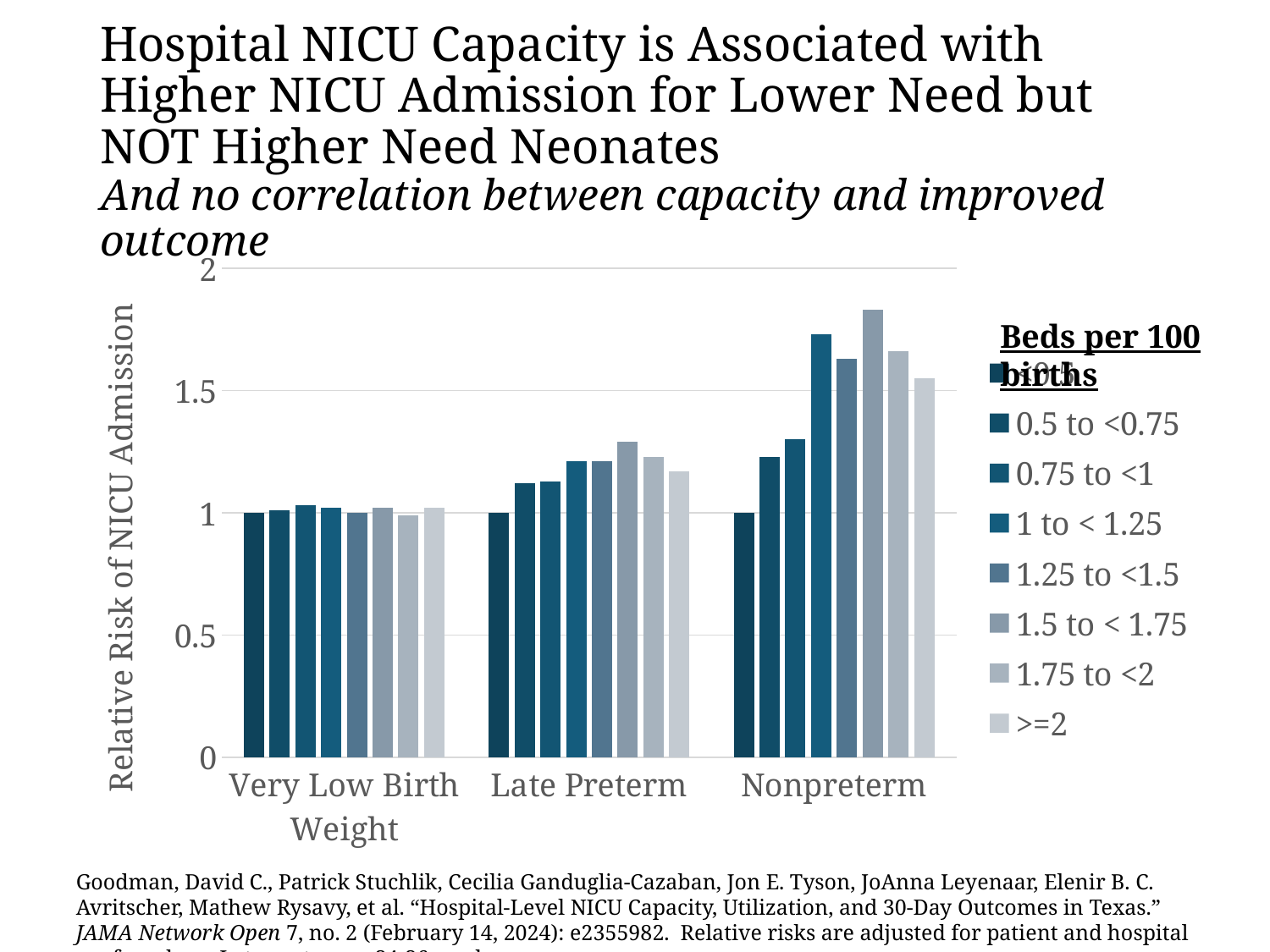
What kind of chart is shown on the slide? bar chart What is the title of the y axis? Relative Risk of NICU Admission For the >=2 series, which is larger: the value for Late Preterm or the value for Very Low Birth Weight? Late Preterm Within the Nonpreterm group, which series has the highest relative risk? 1.5 to < 1.75 How many categories are shown on the x axis of the chart? 3 What is the heading of the legend? Beds per 100 births For the >=2 series, do the values rise or fall moving from Very Low Birth Weight to Nonpreterm along the x axis? rise Is the value for the 1.5 to < 1.75 series in the Late Preterm group greater or less than 1.5? less How many series does the chart's legend list? 8 Is the value for the 1.75 to <2 series in the Nonpreterm group greater or less than 1.5? greater Within the Late Preterm group, which series has the highest relative risk? 1.5 to < 1.75 Which category contains the tallest bar in the chart? Nonpreterm